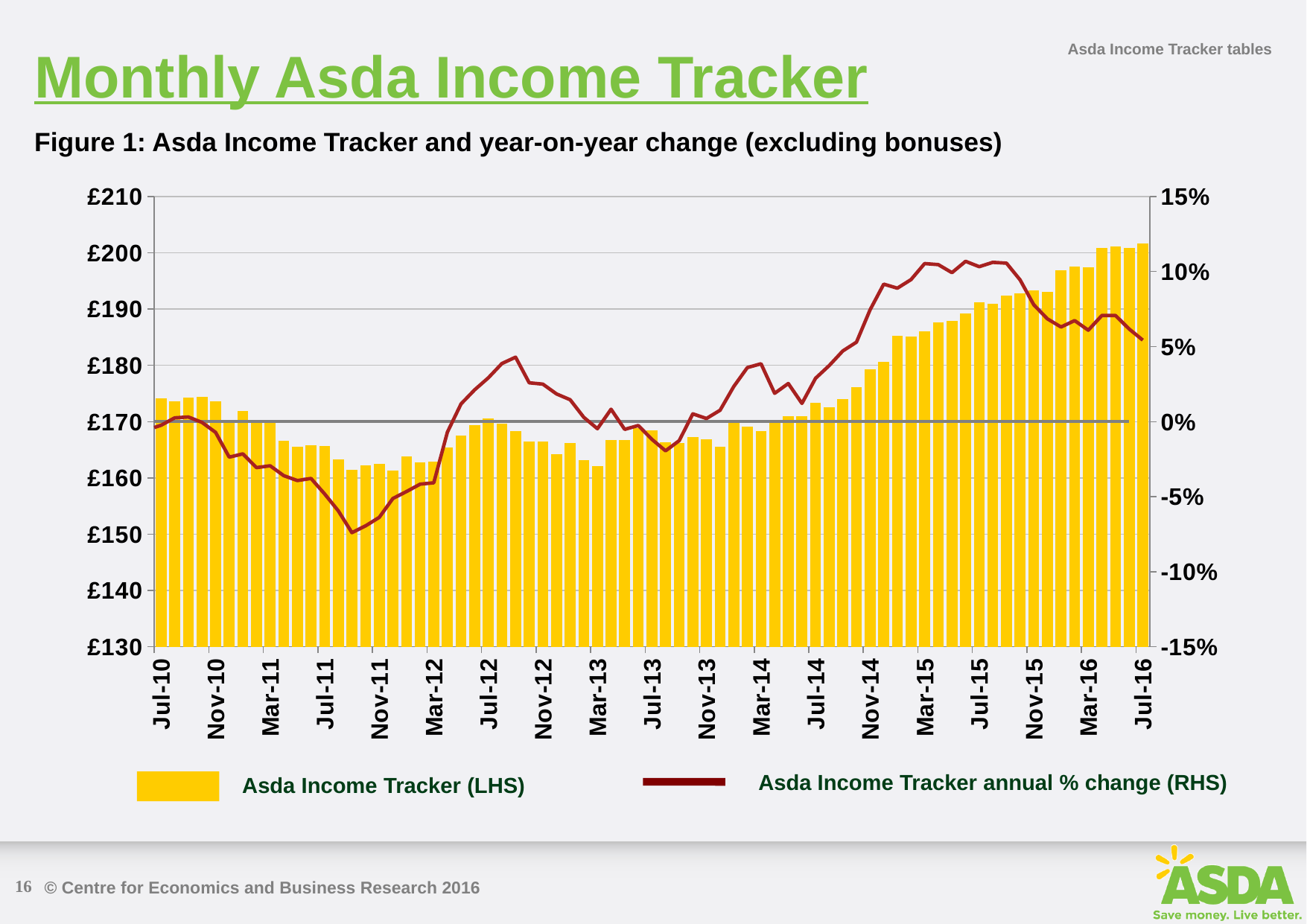
Is the Asda Income Tracker bar for Nov-11 greater or less than £170? less Which series is plotted as yellow bars? Asda Income Tracker (LHS) Is the annual % change line for Mar-15 greater or less than 5%? greater Is the Asda Income Tracker bar for Jul-16 greater or less than £190? greater Do the Asda Income Tracker bars rise or fall between Jul-14 and Jul-16? rise What kind of chart is shown in Figure 1? A combined bar and line chart Which has the taller Asda Income Tracker bar, Jul-10 or Jul-16? Jul-16 How many series does the legend list? 2 Which series is plotted as the dark red line? Asda Income Tracker annual % change (RHS) Which has the taller Asda Income Tracker bar, Nov-11 or Mar-15? Mar-15